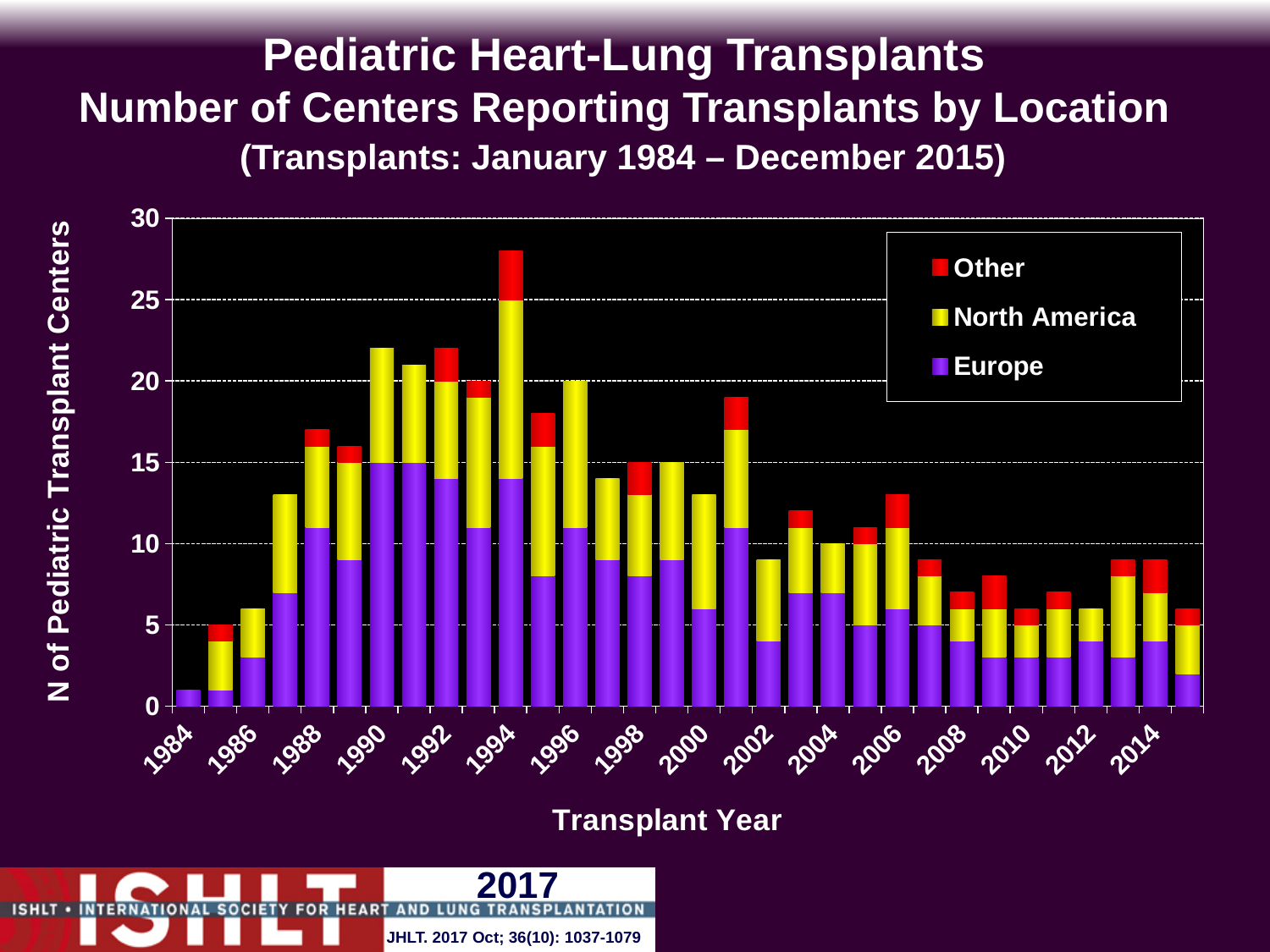
Is the total number of centers for 1994 greater or less than 25? greater Which transplant year has the highest total number of centers? 1994 Which year has a larger total number of centers, 1990 or 2010? 1990 Is the total number of centers for 1990 greater or less than 20? greater Is the total number of centers for 1987 greater or less than 10? greater What kind of chart is shown on the slide? Stacked bar chart What is the label of the y axis? N of Pediatric Transplant Centers How many series does the legend list? 3 Which series are listed in the legend? Other, North America, Europe Which transplant year has the lowest total number of centers? 1984 Do the total numbers of centers generally rise or fall from 1994 to 2015? fall